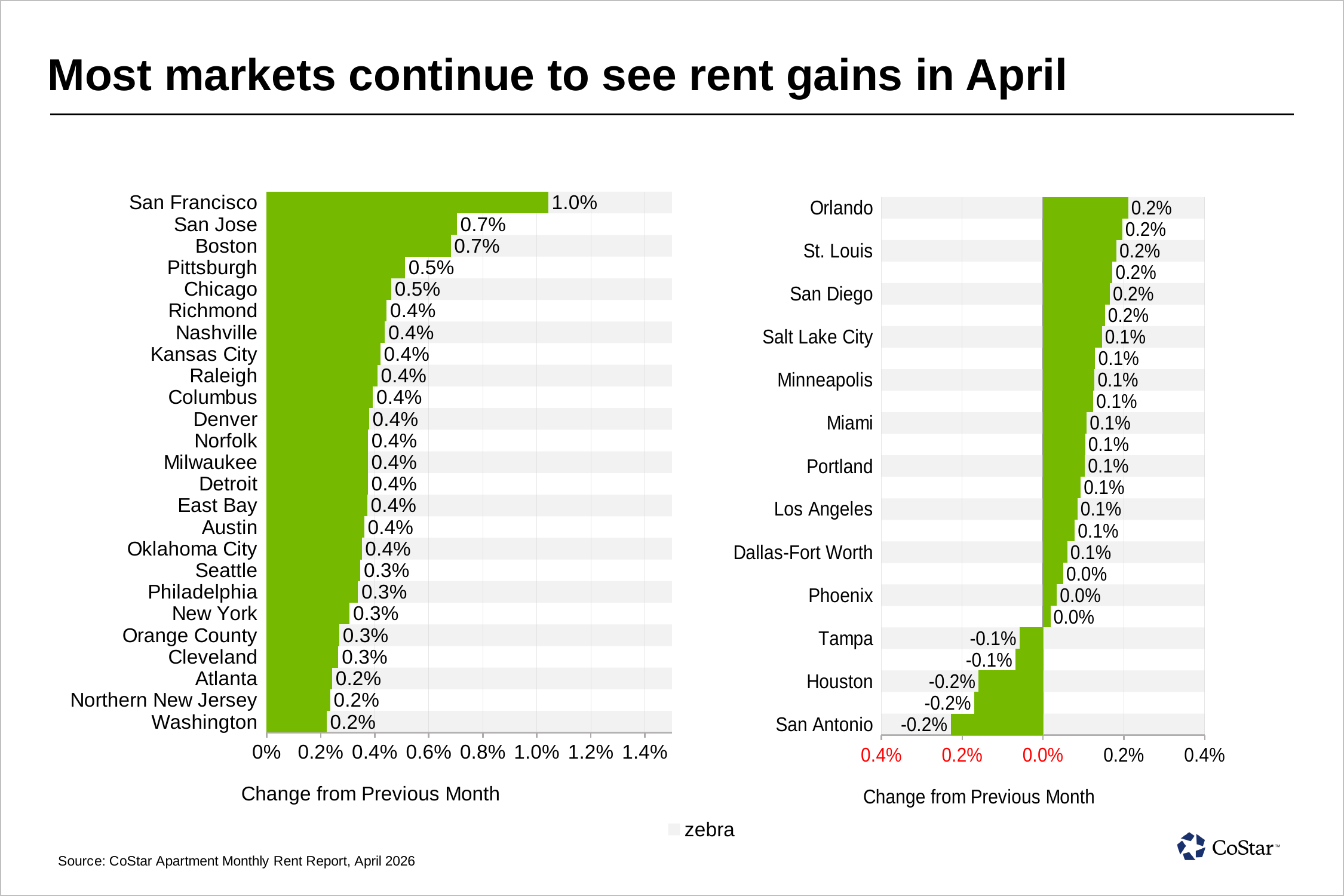
In the left chart, what is the change from previous month for San Francisco? 1.0% In the right chart, what is the difference between the values for Orlando and San Antonio? 0.4% In the left chart, what is the value for Pittsburgh? 0.5% What is the x-axis title of the left chart? Change from Previous Month In the right chart, what is the change from previous month for San Antonio? -0.2% In the left chart, what is the difference between the values for San Francisco and Washington? 0.8% In the left chart, which has the larger value, Boston or Chicago? Boston In the right chart, which has the larger value, Orlando or Houston? Orlando In the left chart, which market has the highest change from previous month? San Francisco What kind of chart is the left chart? Bar chart In the right chart, what is the value for Phoenix? 0.0% How many markets are listed in the left chart? 25